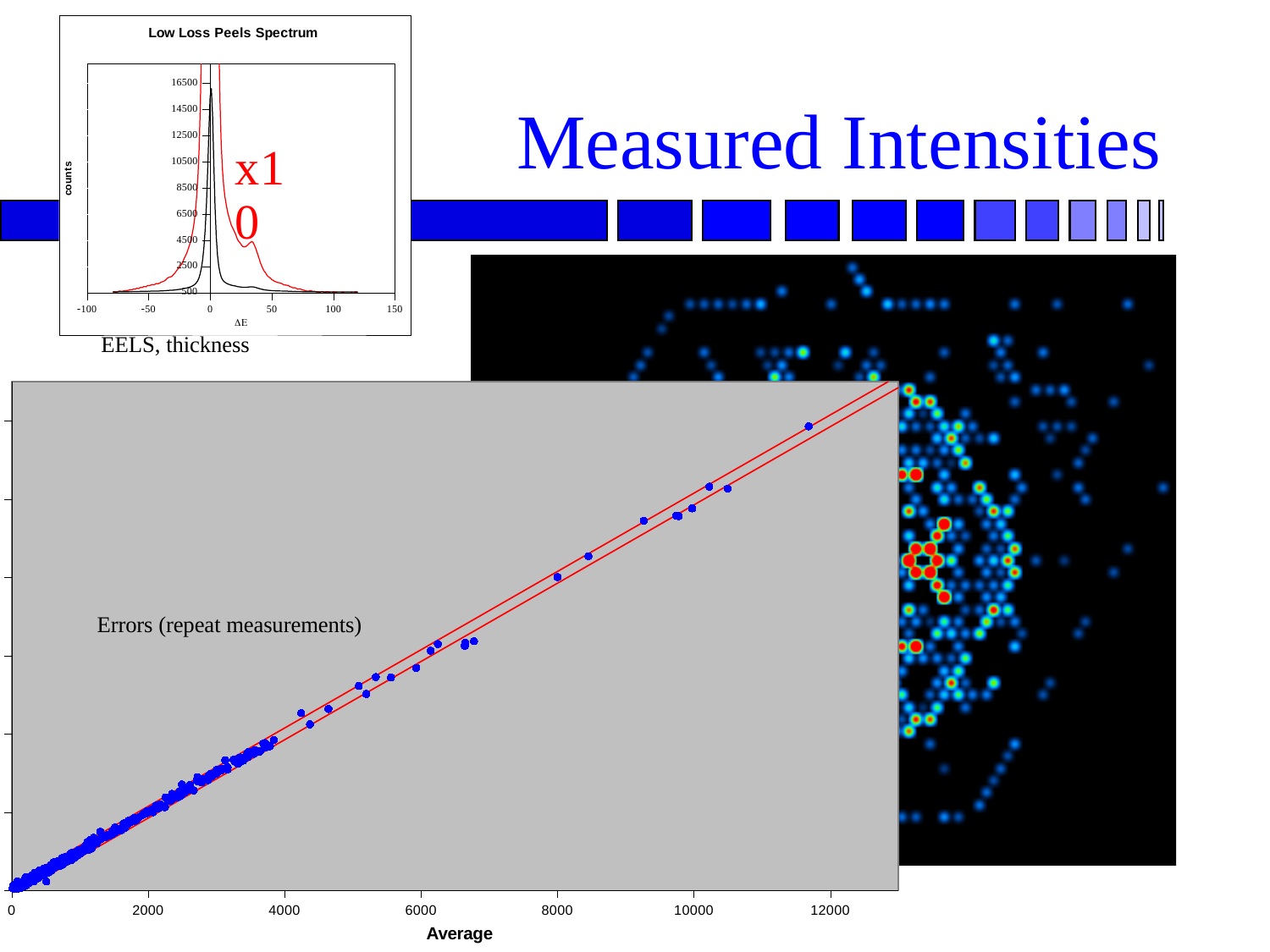
In the bottom scatter chart, what text annotation is written inside the plot area? Errors (repeat measurements) What kind of chart is the top-left chart titled 'Low Loss Peels Spectrum'? line chart What kind of chart is the bottom chart with the x axis labelled 'Average'? scatter chart In the bottom scatter chart, what is the label on the x axis? Average In the 'Low Loss Peels Spectrum' chart, what scale factor is written in red next to the red curve? x10 In the bottom scatter chart, is the x value of the rightmost point greater or less than 10000? greater In the 'Low Loss Peels Spectrum' chart, how many curves are plotted? 2 In the 'Low Loss Peels Spectrum' chart, what is the highest value shown on the y axis? 16500 In the bottom scatter chart, what is the highest tick value shown on the x axis? 12000 In the bottom scatter chart, do the plotted points rise or fall as the x axis increases? rise